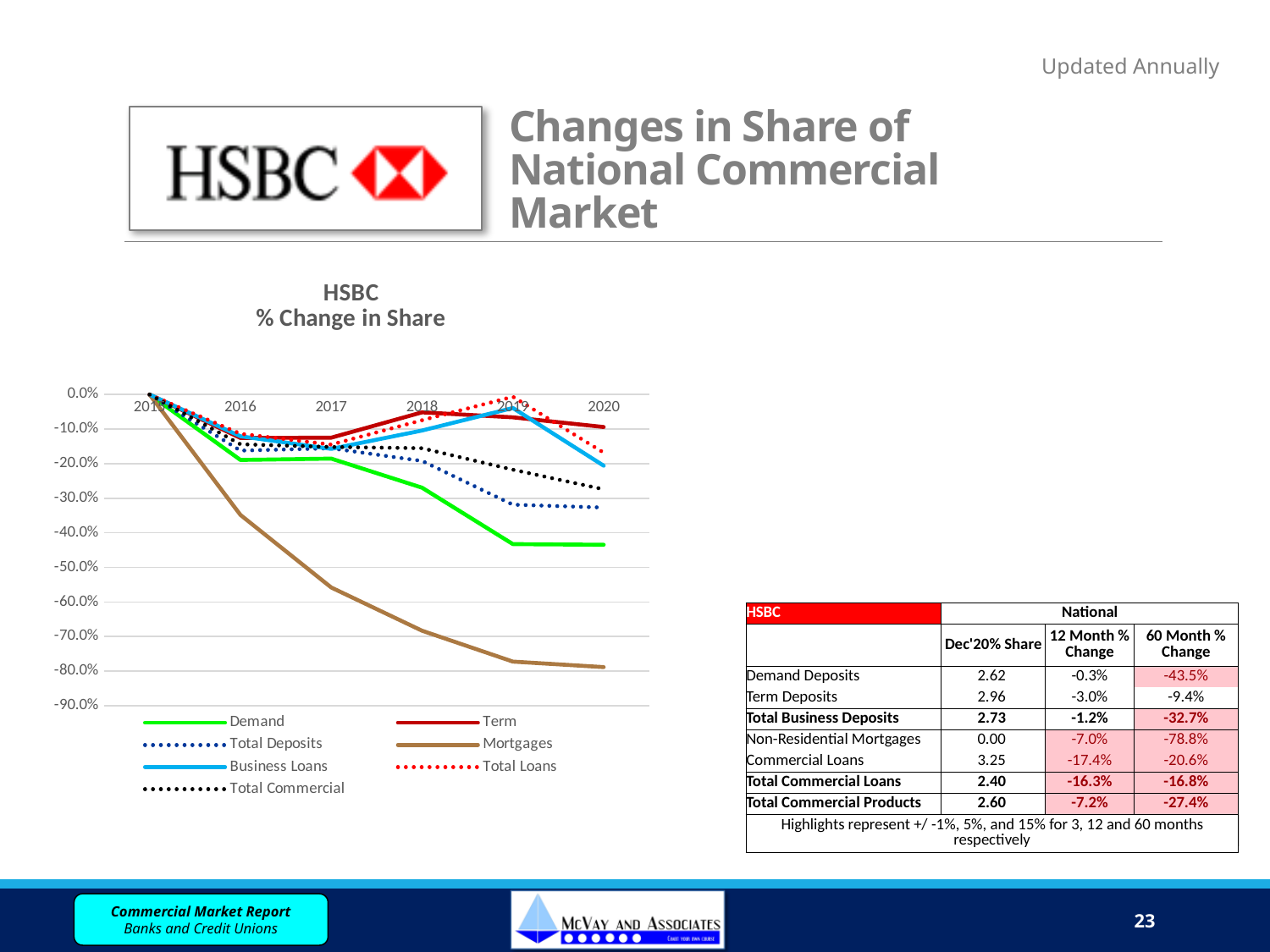
What is the title of the chart? HSBC % Change in Share In 2020, which is larger: the value for Term or the value for Mortgages? Term How many years are shown along the x axis of the chart? 6 Which series has the lowest value in 2020? Mortgages Is the value for Term in 2020 greater or less than -20.0%? greater Is the value for Mortgages in 2020 greater or less than -70.0%? less How many series does the chart legend list? 7 What kind of chart is shown on the slide? line chart Is the value for Total Commercial in 2020 greater or less than -40.0%? greater Which series has the highest value in 2020? Term Does the Mortgages series rise or fall from 2015 to 2020? fall